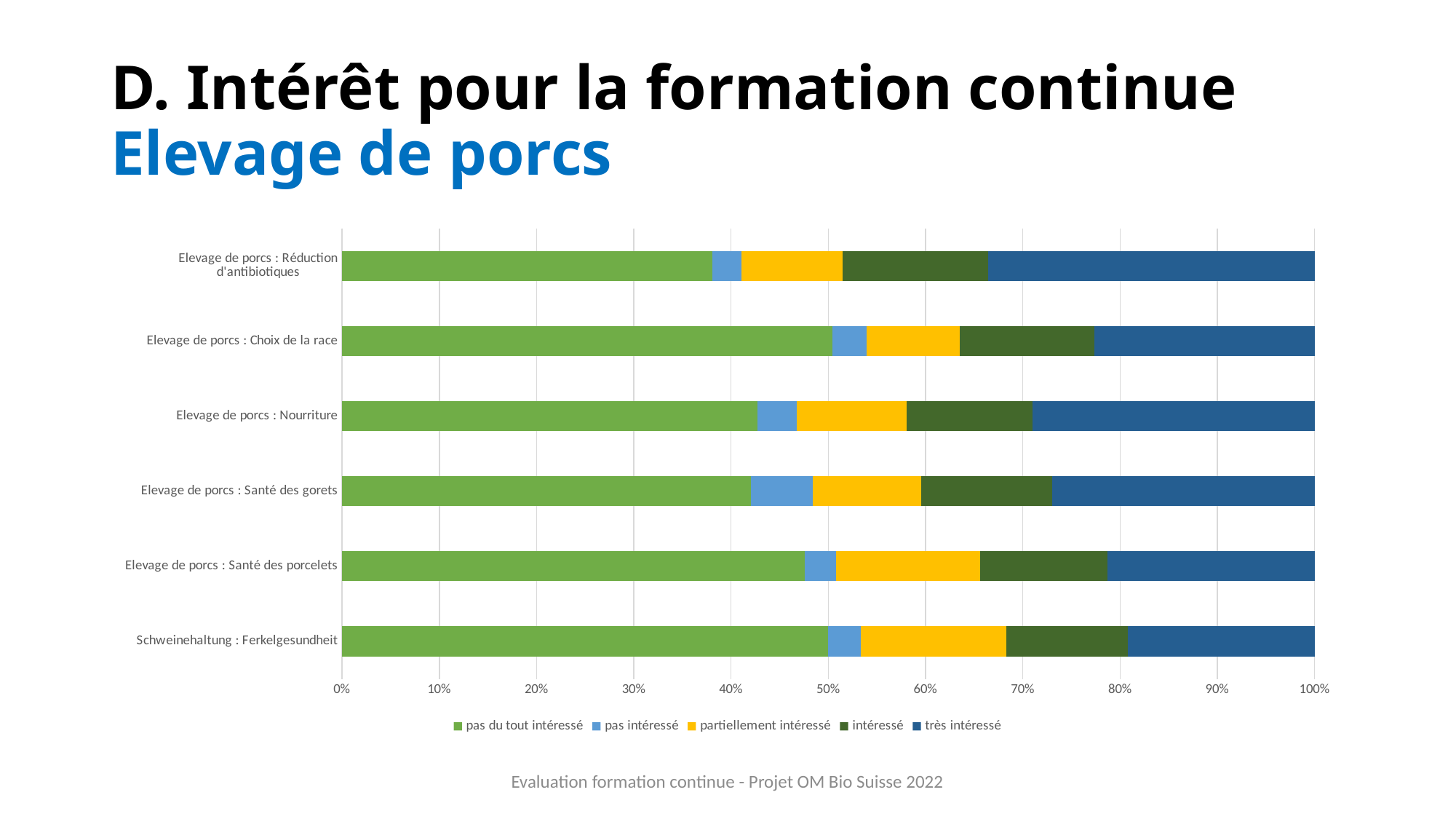
How many series does the legend list? 5 Which category has the smallest 'pas du tout intéressé' segment? Elevage de porcs : Réduction d'antibiotiques Is the 'pas du tout intéressé' value for 'Elevage de porcs : Santé des gorets' greater or less than 50%? less Which series is listed first in the legend? pas du tout intéressé Is the 'pas du tout intéressé' value for 'Elevage de porcs : Réduction d'antibiotiques' greater or less than 40%? less What kind of chart is shown on the slide? Stacked bar chart Which has the larger 'pas du tout intéressé' segment: 'Elevage de porcs : Choix de la race' or 'Elevage de porcs : Réduction d'antibiotiques'? Elevage de porcs : Choix de la race What value does each stacked bar total on the x axis? 100% Which has the larger 'très intéressé' segment: 'Elevage de porcs : Réduction d'antibiotiques' or 'Elevage de porcs : Santé des porcelets'? Elevage de porcs : Réduction d'antibiotiques Is the 'pas du tout intéressé' value for 'Elevage de porcs : Nourriture' greater or less than 40%? greater Which category has the largest 'très intéressé' segment? Elevage de porcs : Réduction d'antibiotiques How many categories (bars) does the chart show? 6